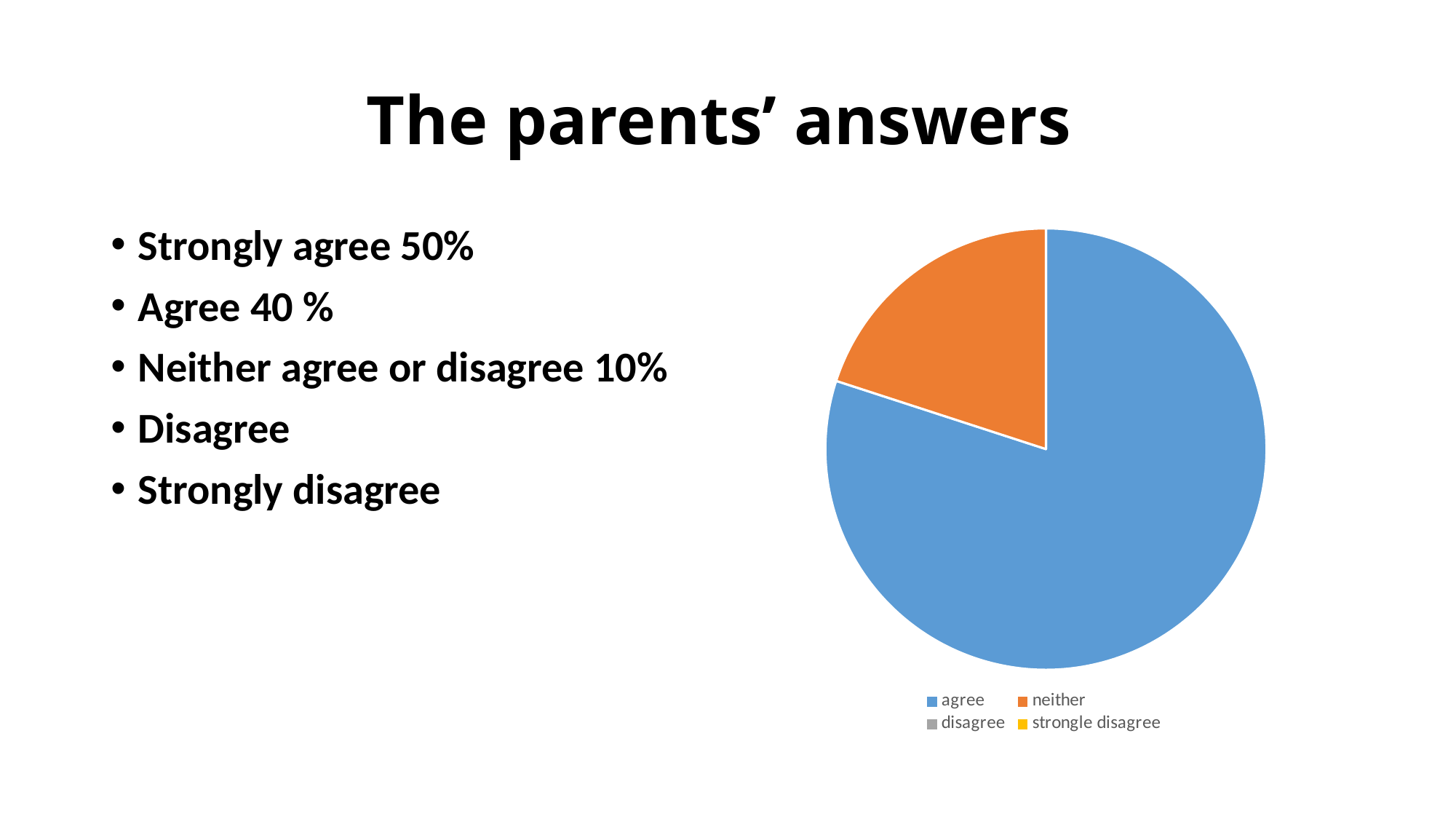
How many entries does the chart's legend list? 4 Does the agree slice take up more or less than half of the pie? more What colour is the neither slice in the pie chart? orange Which category has the largest slice of the pie? agree Which slice is larger, agree or neither? agree What colour is the agree slice in the pie chart? blue How many slices are visible in the pie chart? 2 What kind of chart is shown on the slide? pie chart